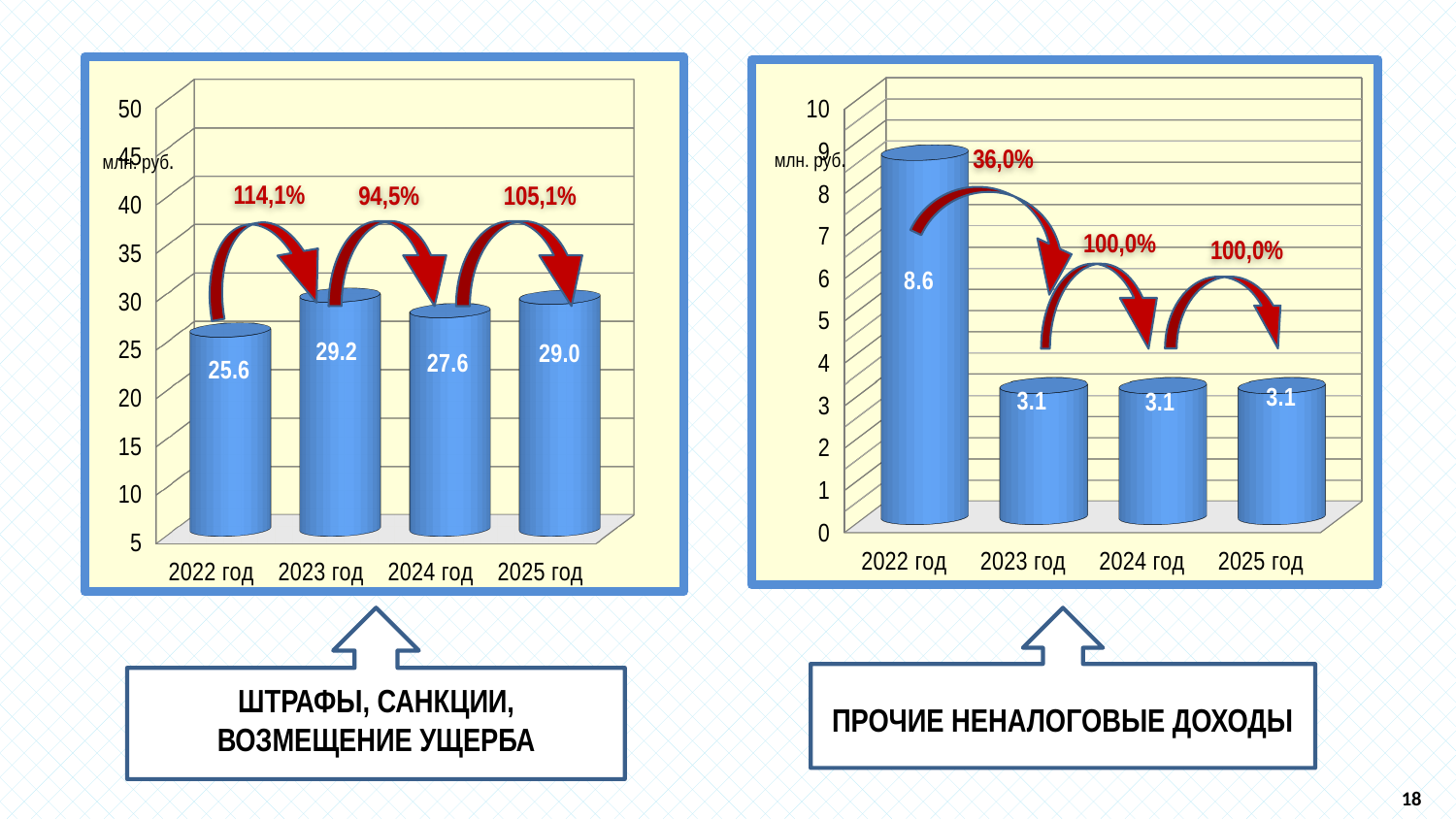
In the right chart (ПРОЧИЕ НЕНАЛОГОВЫЕ ДОХОДЫ), what is the value for 2022 год? 8.6 In the left chart (ШТРАФЫ, САНКЦИИ, ВОЗМЕЩЕНИЕ УЩЕРБА), what is the value for 2024 год? 27.6 In the left chart (ШТРАФЫ, САНКЦИИ, ВОЗМЕЩЕНИЕ УЩЕРБА), what is the value for 2022 год? 25.6 In the right chart (ПРОЧИЕ НЕНАЛОГОВЫЕ ДОХОДЫ), what is the difference between the values for 2022 год and 2023 год? 5.5 In the right chart (ПРОЧИЕ НЕНАЛОГОВЫЕ ДОХОДЫ), what is the value for 2025 год? 3.1 In the left chart (ШТРАФЫ, САНКЦИИ, ВОЗМЕЩЕНИЕ УЩЕРБА), what is the difference between the values for 2023 год and 2022 год? 3.6 In the left chart (ШТРАФЫ, САНКЦИИ, ВОЗМЕЩЕНИЕ УЩЕРБА), which year has the highest value? 2023 год In the right chart (ПРОЧИЕ НЕНАЛОГОВЫЕ ДОХОДЫ), which year has the highest value? 2022 год In the left chart (ШТРАФЫ, САНКЦИИ, ВОЗМЕЩЕНИЕ УЩЕРБА), which year has the lowest value? 2022 год How many years (categories) are shown in the right chart (ПРОЧИЕ НЕНАЛОГОВЫЕ ДОХОДЫ)? 4 What type of chart is the left chart (ШТРАФЫ, САНКЦИИ, ВОЗМЕЩЕНИЕ УЩЕРБА)? Bar chart In the left chart (ШТРАФЫ, САНКЦИИ, ВОЗМЕЩЕНИЕ УЩЕРБА), what percentage is shown above the arrow between 2022 год and 2023 год? 114,1%